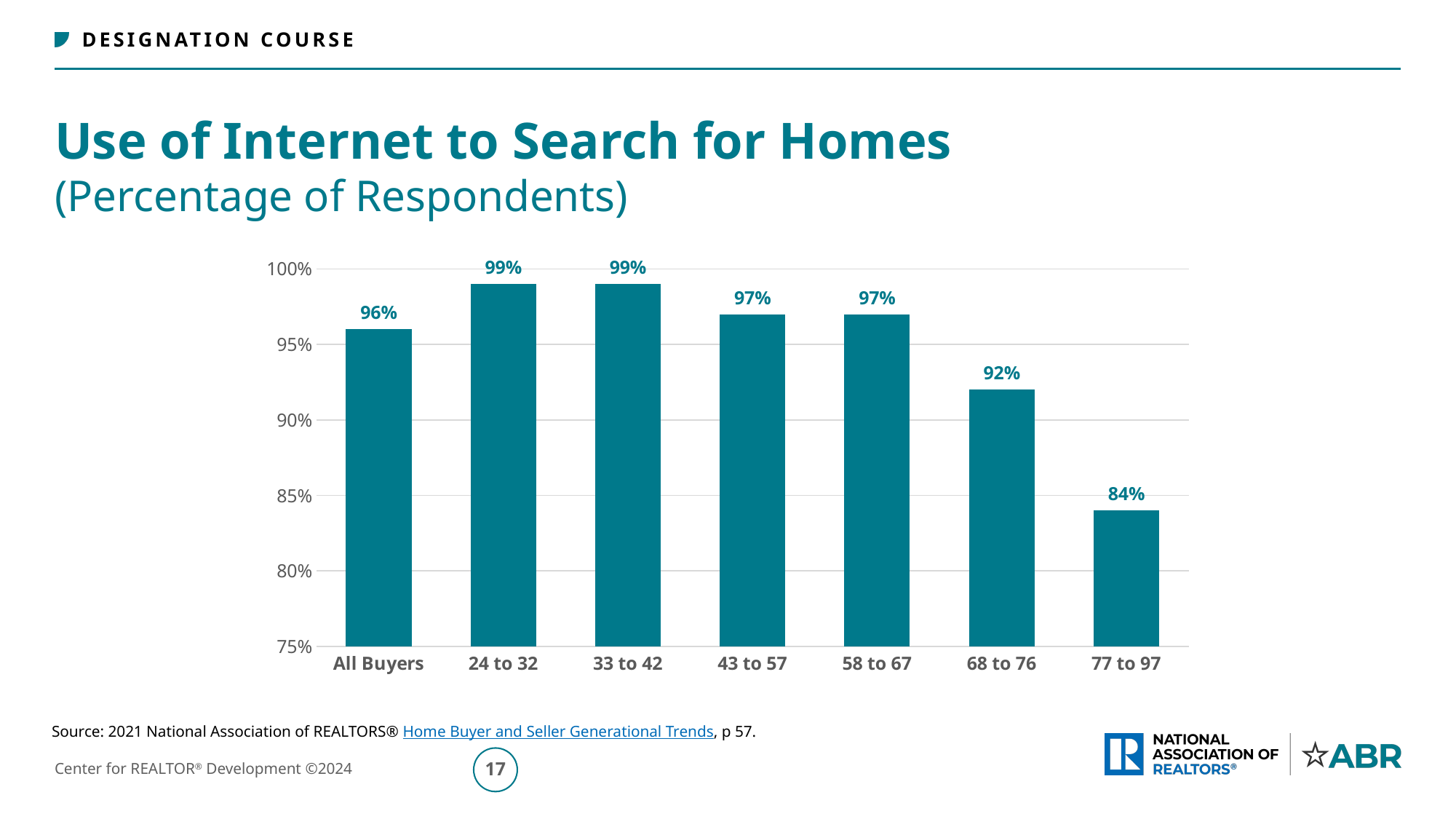
Do the values rise or fall across the age groups from 33 to 42 through 77 to 97? fall How many categories are shown on the x axis? 7 What kind of chart is shown on the slide? bar chart What is the difference between the value for All Buyers and the value for 68 to 76? 4% What is the value for the 77 to 97 age group? 84% Which is larger, the value for 43 to 57 or the value for 68 to 76? 43 to 57 What is the value for the 68 to 76 age group? 92% Which age group has the lowest percentage of respondents using the internet to search for homes? 77 to 97 What is the difference between the value for 24 to 32 and the value for 77 to 97? 15% What is the title of the chart? Use of Internet to Search for Homes (Percentage of Respondents) What percentage of All Buyers used the internet to search for homes? 96% Is the value for 77 to 97 greater or less than 85%? less